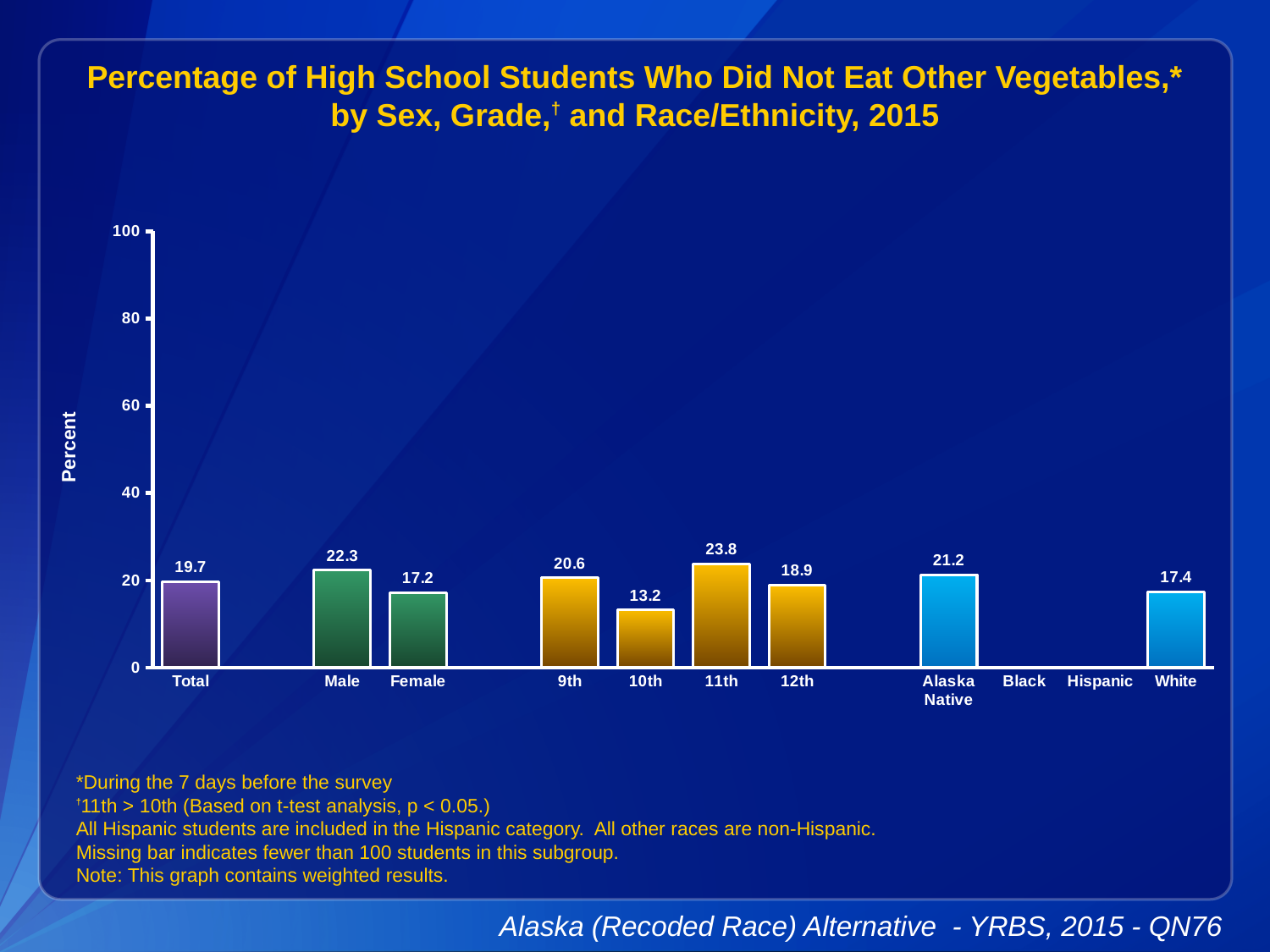
Is the value for 11th grade greater or less than 20? greater What is the difference between the Male and Female values? 5.1 What is the value for Total? 19.7 What kind of chart is shown on the slide? bar chart How many categories have a bar shown in the chart? 9 Which is larger, the value for 9th grade or the value for 12th grade? 9th What is the label on the y axis? Percent What is the value for 10th grade? 13.2 Which category with a bar has the lowest value? 10th What is the value for Male? 22.3 Which category has the highest value? 11th What is the value for Alaska Native? 21.2